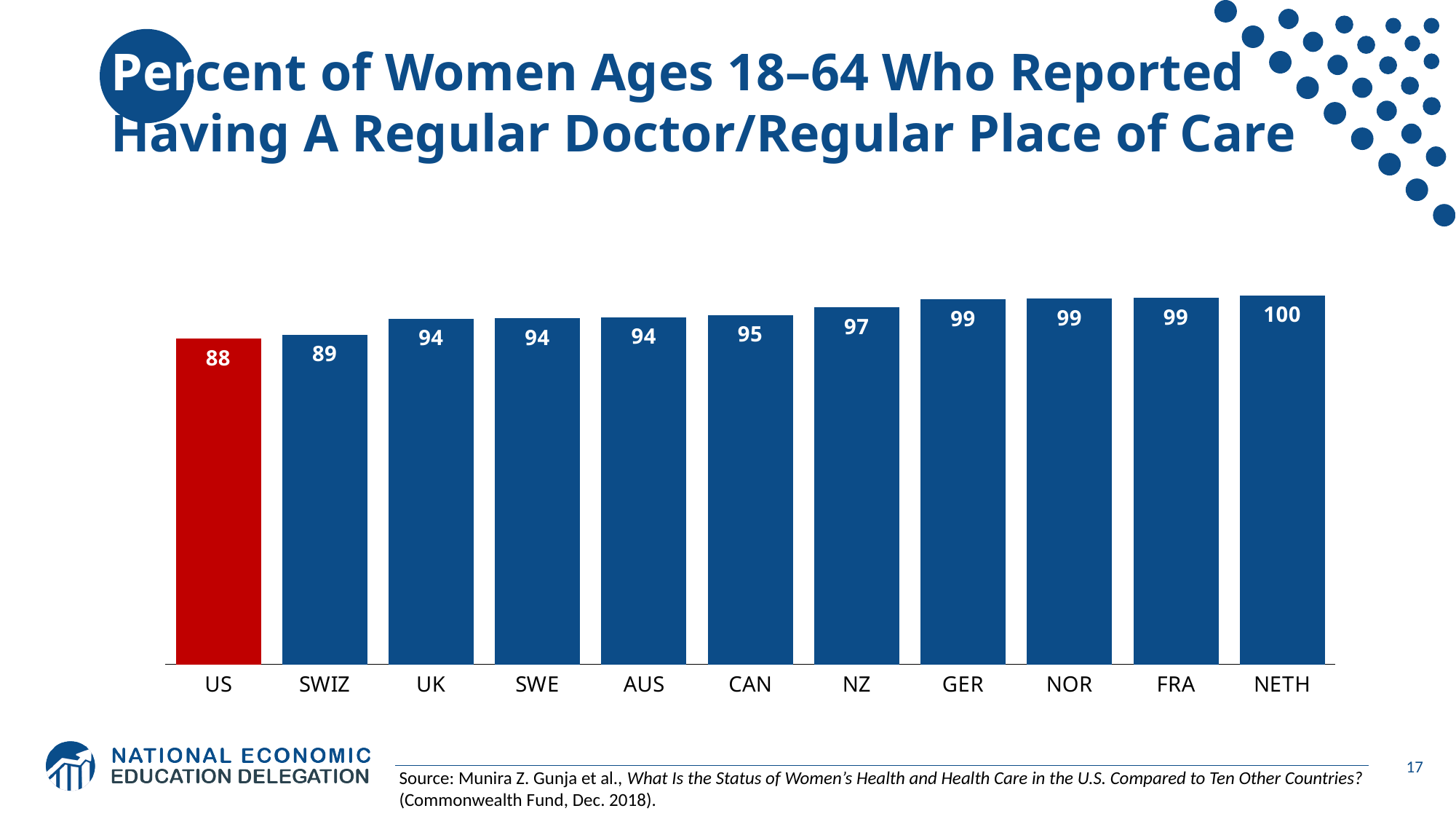
What is the value for NZ? 97 What kind of chart is shown on the slide? Bar chart What is the difference between the values for SWIZ and the US? 1 What is the value for the US? 88 What is the value for CAN? 95 Which has a larger value, UK or GER? GER Which country has the lowest value? US What is the difference between the values for NETH and the US? 12 How many countries are shown in the chart? 11 Which bar is coloured red rather than blue? US Which country has the highest value? NETH Do the values rise or fall from left to right across the chart? Rise